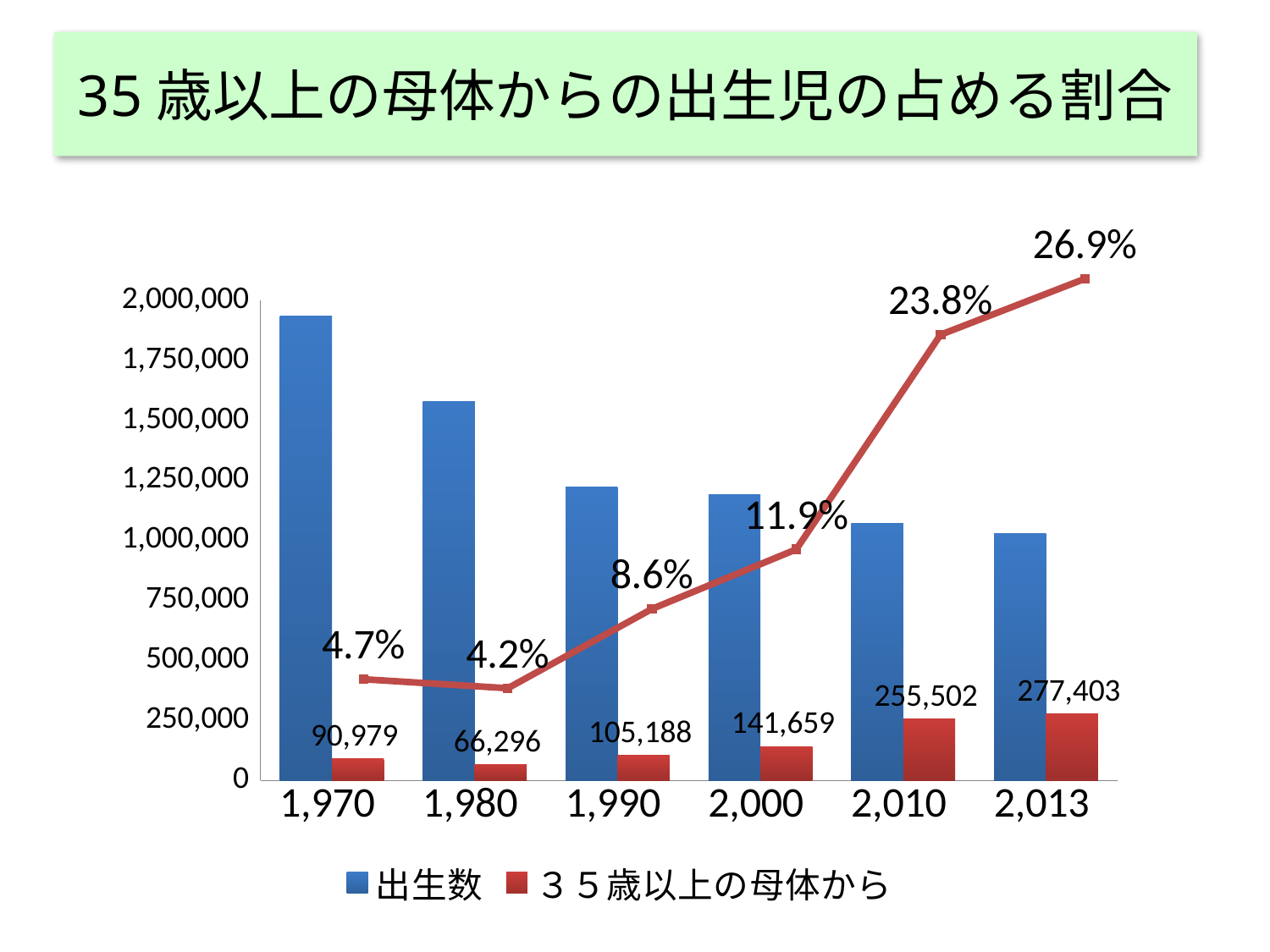
Which is larger, the 35歳以上の母体から value for 1,990 or for 2,000? 2,000 Is the 出生数 value for 1,970 greater or less than 1,750,000? greater In which year is the 35歳以上の母体から value lowest? 1,980 In which year is the 出生数 bar highest? 1,970 Do the 出生数 bars rise or fall from 1,970 to 2,013? fall How many series does the legend list? 2 What percentage is shown on the line for 2,010? 23.8% What percentage is shown on the line for 1,970? 4.7% What is the value of the 35歳以上の母体から series for 2,013? 277,403 What is the difference between the 35歳以上の母体から values for 2,013 and 2,010? 21,901 What is the value of the 35歳以上の母体から series for 1,980? 66,296 How many years are shown on the x axis? 6